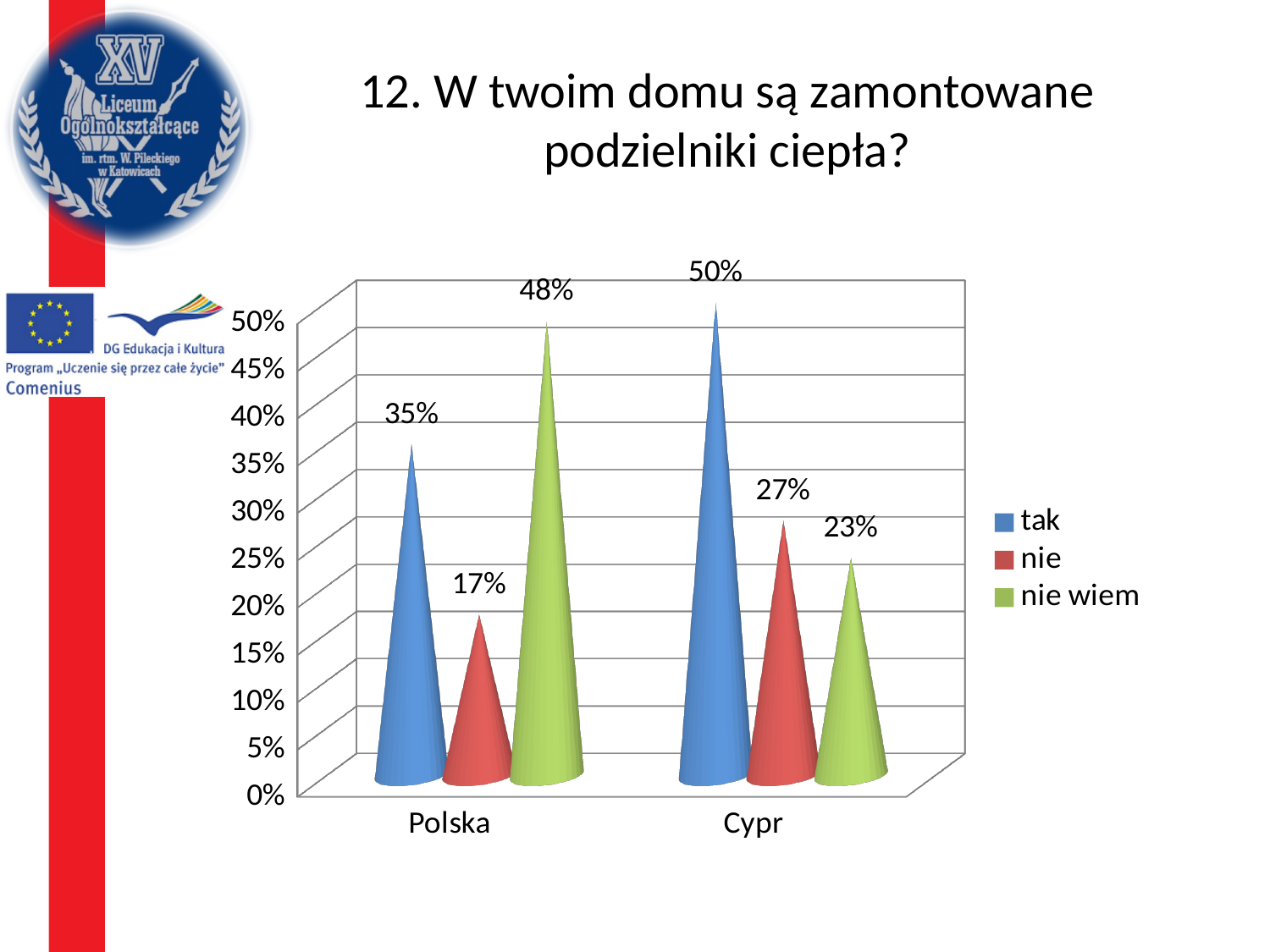
How many categories are shown on the x axis? 2 What is the value for "nie wiem" in Polska? 48% Which series has the lowest value for Polska? nie What is the value for "nie" in Cypr? 27% Which series has the highest value for Cypr? tak Which is larger: "nie wiem" for Polska or "nie wiem" for Cypr? Polska What is the difference between the "tak" values for Cypr and Polska? 15% What kind of chart is shown on the slide? bar chart What colour represents the "nie" series in the legend? red What is the value for "tak" in Cypr? 50% What is the value for "tak" in Polska? 35% How many series does the legend list? 3